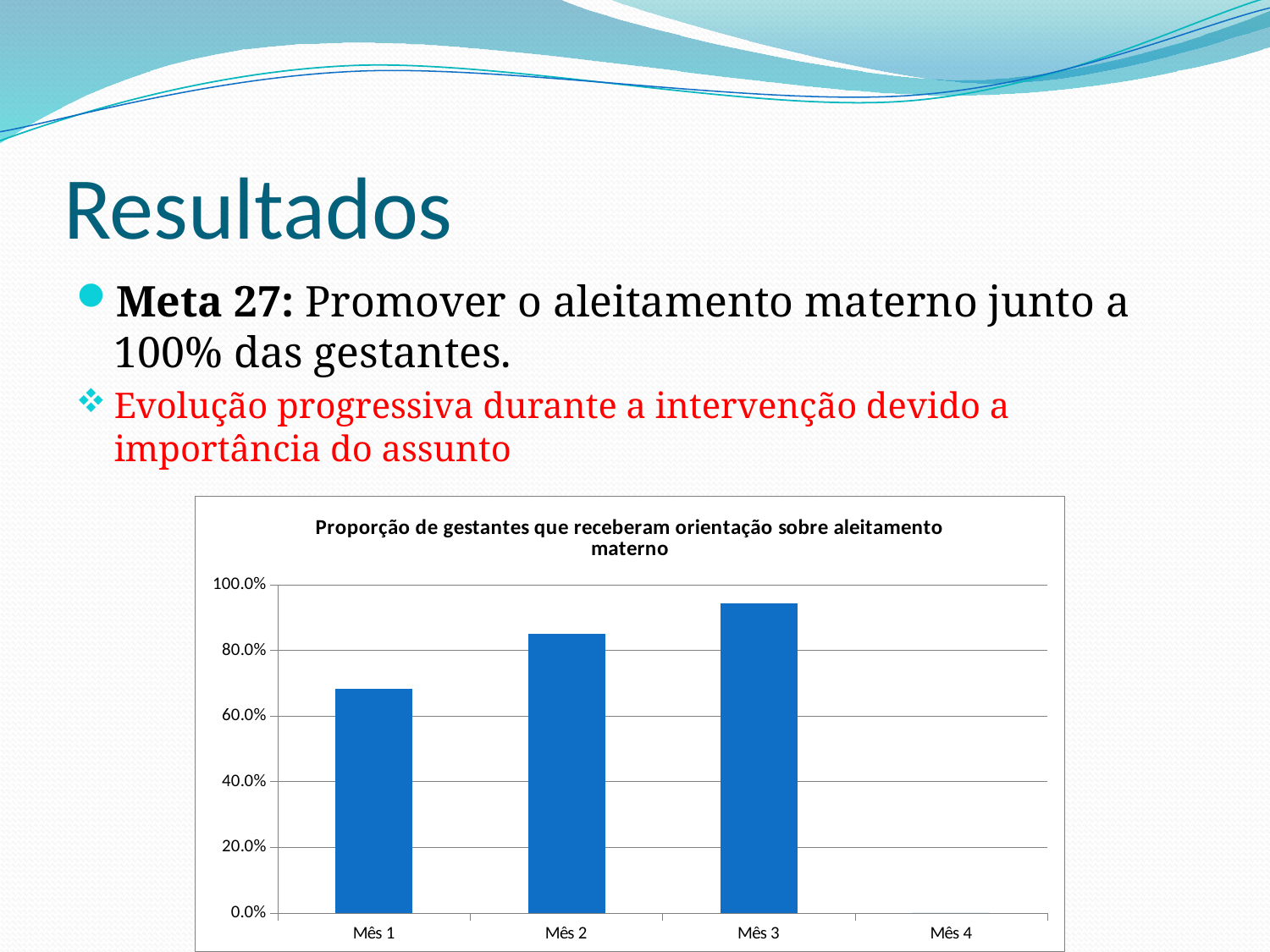
Is the value for Mês 1 greater or less than 80.0%? less Is the value for Mês 1 greater or less than 60.0%? greater How many bars are actually plotted in the chart? 3 What kind of chart is shown on the slide? bar chart Which is larger, the value for Mês 2 or the value for Mês 1? Mês 2 Which month has the highest bar in the chart? Mês 3 Do the bar values rise or fall from Mês 1 to Mês 3? rise Is the value for Mês 3 greater or less than 100.0%? less How many categories are labelled on the x axis of the chart? 4 What is the title of the chart? Proporção de gestantes que receberam orientação sobre aleitamento materno Among the months with a visible bar, which has the lowest value? Mês 1